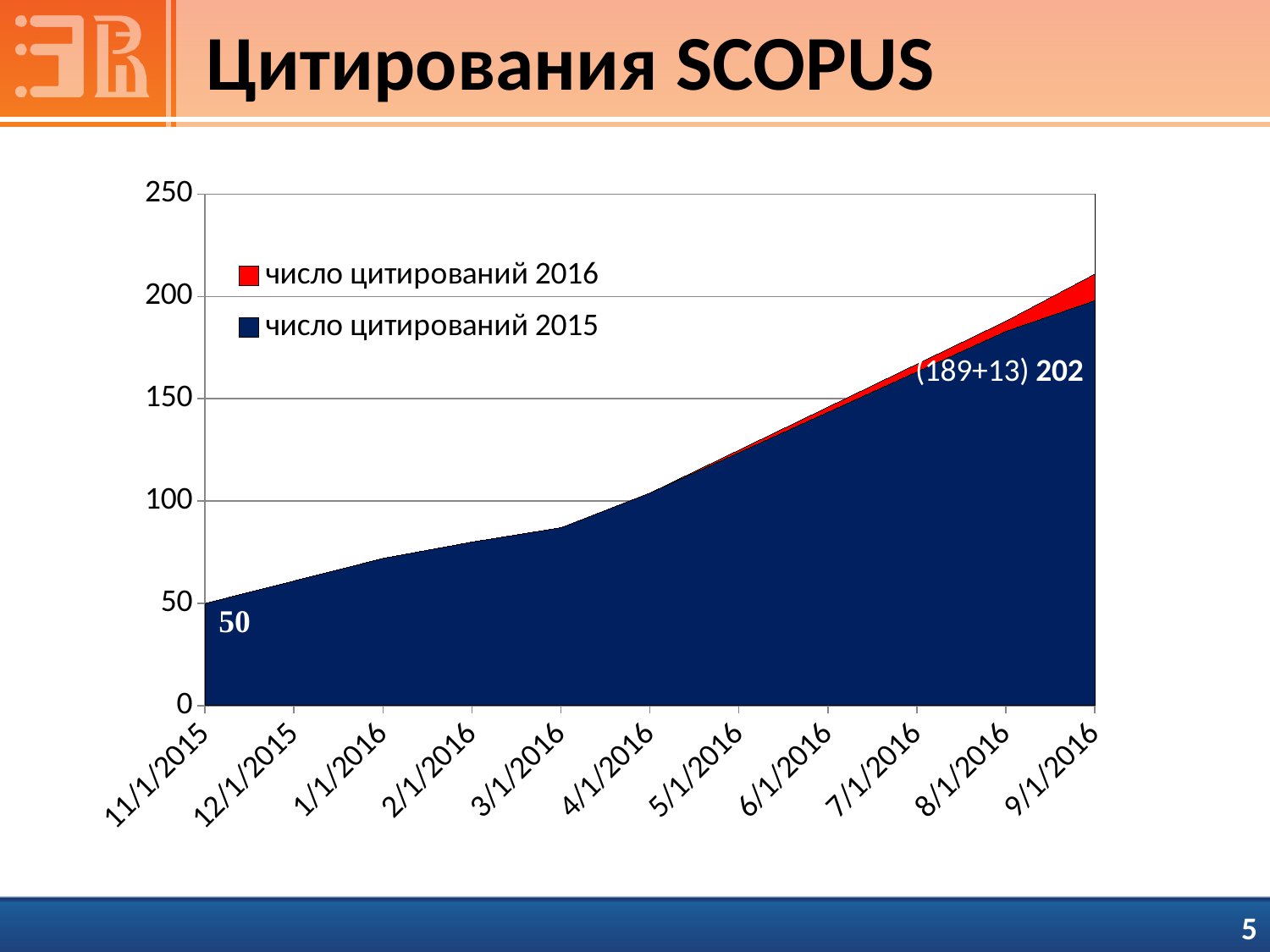
What value is labelled for число цитирований 2015 at 11/1/2015? 50 How many dates are labelled on the x axis? 11 At which date is the number of citations lowest? 11/1/2015 What kind of chart is shown on the slide? area chart At which date is the total number of citations highest? 9/1/2016 What are the two series named in the legend? число цитирований 2016 and число цитирований 2015 What data label is printed near the right end of the chart? (189+13) 202 Is the value for число цитирований 2015 at 6/1/2016 greater or less than 100? greater Is the value for число цитирований 2015 at 3/1/2016 greater or less than 100? less How many series does the legend list? 2 Do the citation values rise or fall from 11/1/2015 to 9/1/2016? rise Is the total stacked value at 9/1/2016 greater or less than 200? greater